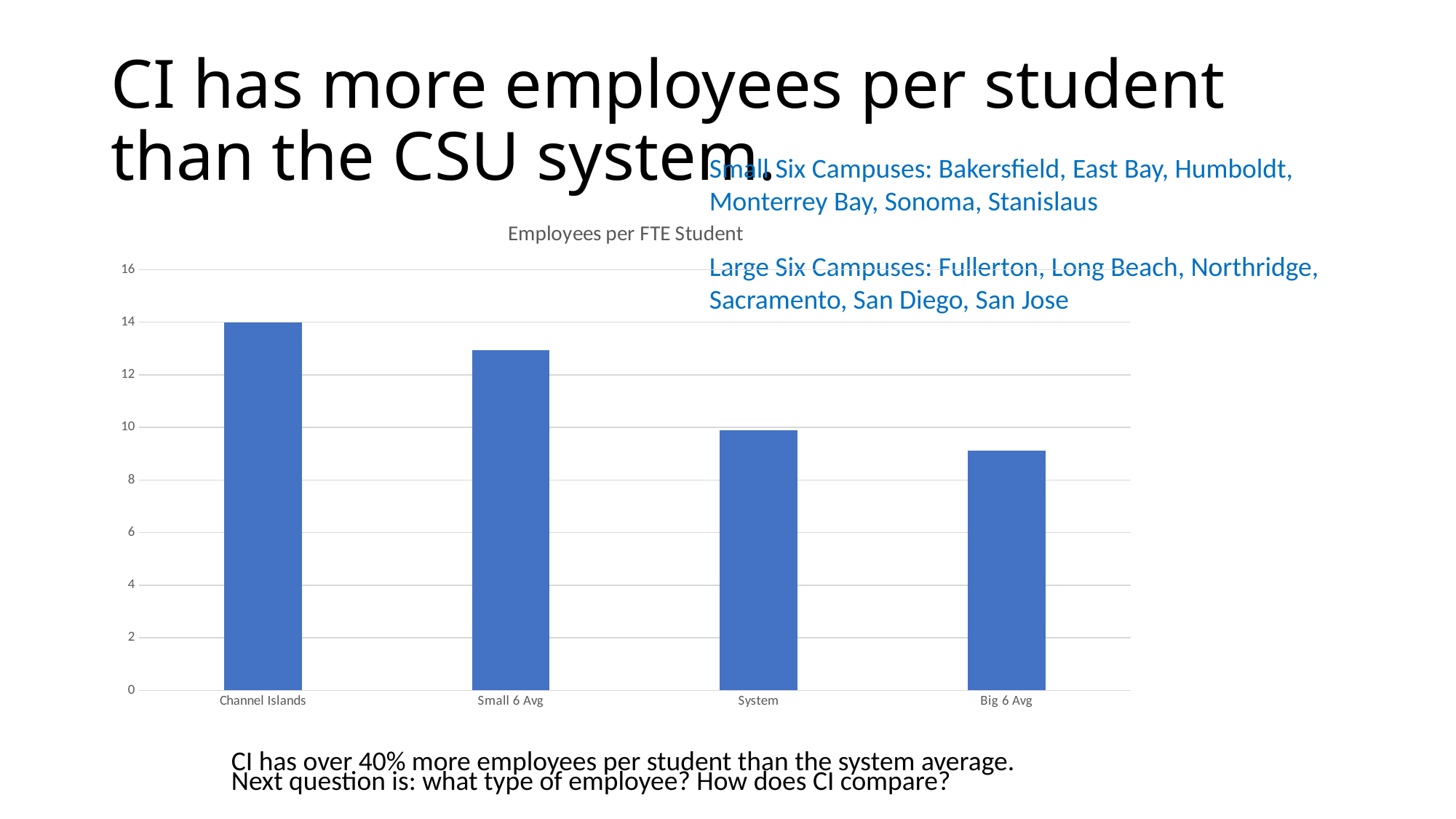
Which is larger, the value for Channel Islands or the value for Big 6 Avg? Channel Islands What is the highest value shown on the vertical axis of the chart? 16 How many categories are plotted in the Employees per FTE Student chart? 4 Which category has the lowest employees per FTE student? Big 6 Avg Do the bar values rise or fall from left to right across the categories? fall Is the value for Small 6 Avg greater or less than 12? greater What kind of chart is shown on the slide? bar chart Is the value for Big 6 Avg greater or less than 8? greater Which category has the highest employees per FTE student? Channel Islands What is the title of the chart? Employees per FTE Student Which is larger, the value for Small 6 Avg or the value for System? Small 6 Avg